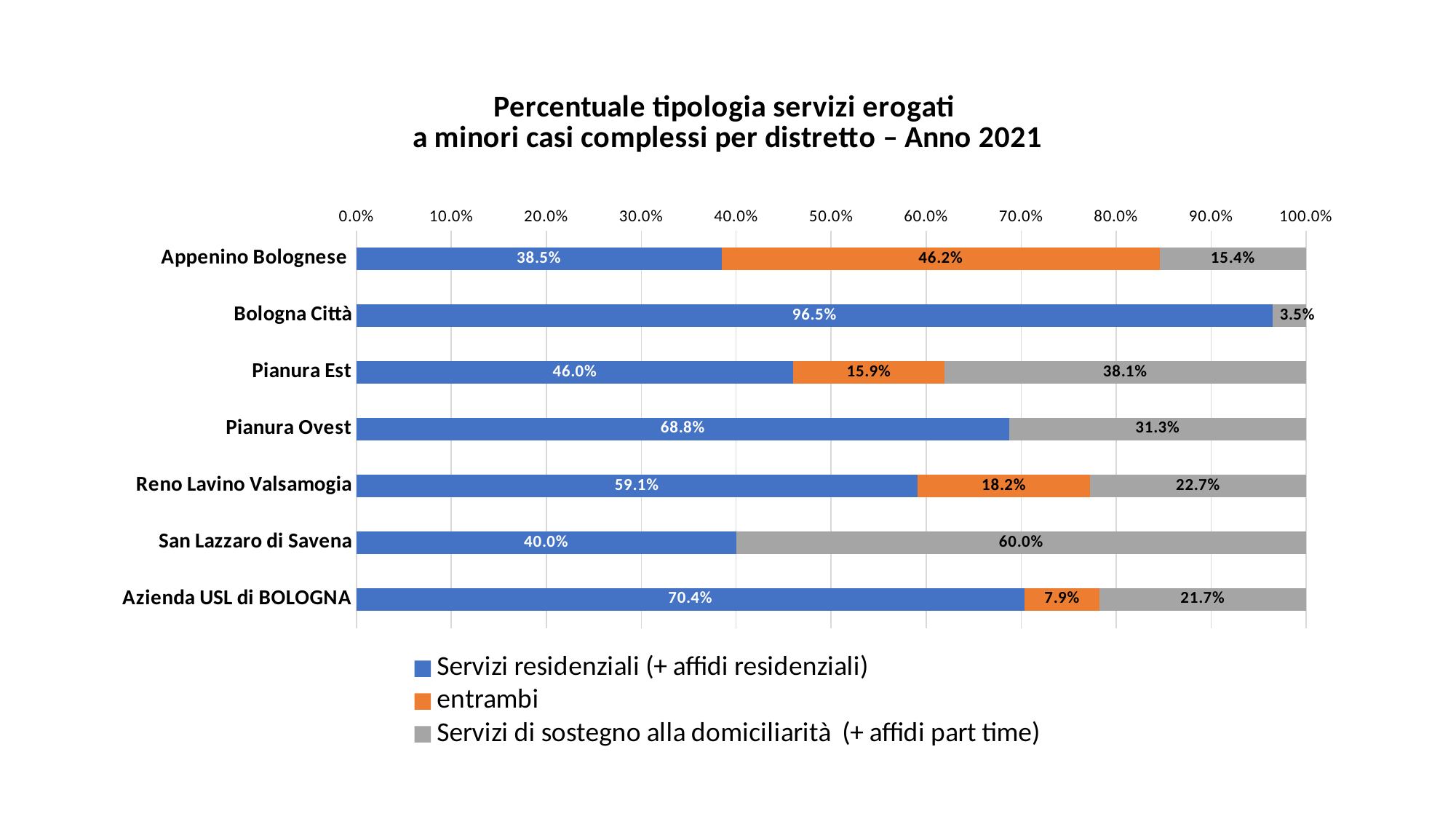
What is the value of Servizi di sostegno alla domiciliarità (+ affidi part time) for San Lazzaro di Savena? 60.0% Which is larger: the entrambi value for Reno Lavino Valsamogia or for Pianura Est? Reno Lavino Valsamogia How many districts (categories) are shown on the chart? 7 What is the value of Servizi residenziali (+ affidi residenziali) for Bologna Città? 96.5% How many series does the legend list? 3 Which district has the highest value for Servizi di sostegno alla domiciliarità (+ affidi part time)? San Lazzaro di Savena Which district has the highest value for Servizi residenziali (+ affidi residenziali)? Bologna Città What is the value of entrambi for Pianura Est? 15.9% What is the difference between the Servizi residenziali and Servizi di sostegno alla domiciliarità values for Pianura Ovest? 37.5 percentage points What is the value of entrambi for Azienda USL di BOLOGNA? 7.9% What kind of chart is shown on the slide? Stacked bar chart Which district has the lowest value for Servizi residenziali (+ affidi residenziali)? Appenino Bolognese